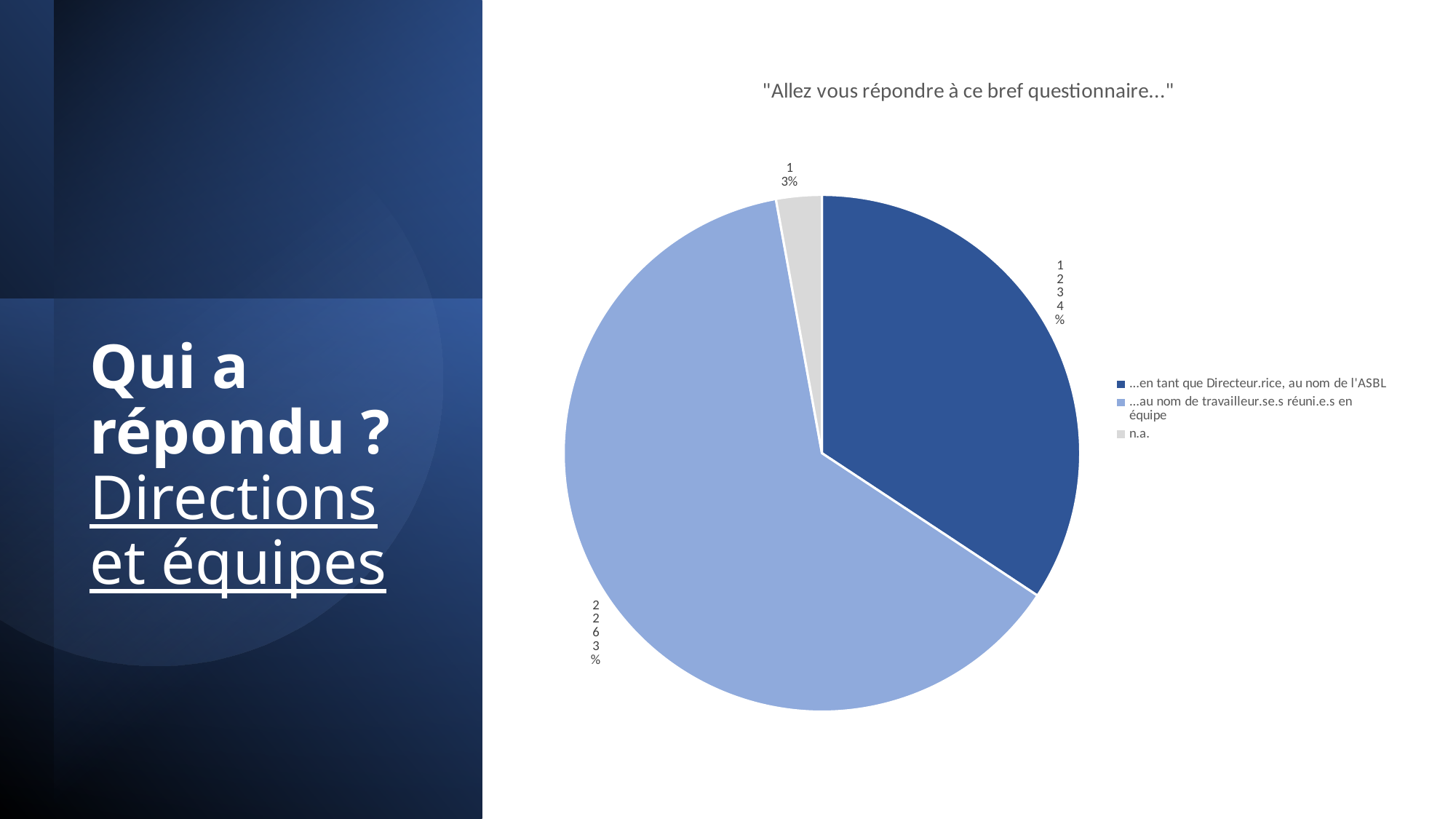
Which category has the largest slice of the pie chart? ...au nom de travailleur.se.s réuni.e.s en équipe What share of the pie does the "n.a." slice represent? 3% Which category has the smallest slice of the pie chart? n.a. What share of the pie does the "...au nom de travailleur.se.s réuni.e.s en équipe" slice represent? 63% How many entries does the legend of the pie chart list? 3 What kind of chart is shown on the slide? pie chart What share of the pie does the "...en tant que Directeur.rice, au nom de l'ASBL" slice represent? 34% What is the title of the pie chart? "Allez vous répondre à ce bref questionnaire..." Is the share for "...au nom de travailleur.se.s réuni.e.s en équipe" greater or less than 50%? greater What colour is the "n.a." slice in the pie chart? grey Which slice is larger: "...en tant que Directeur.rice, au nom de l'ASBL" or "n.a."? ...en tant que Directeur.rice, au nom de l'ASBL How many slices does the pie chart have? 3